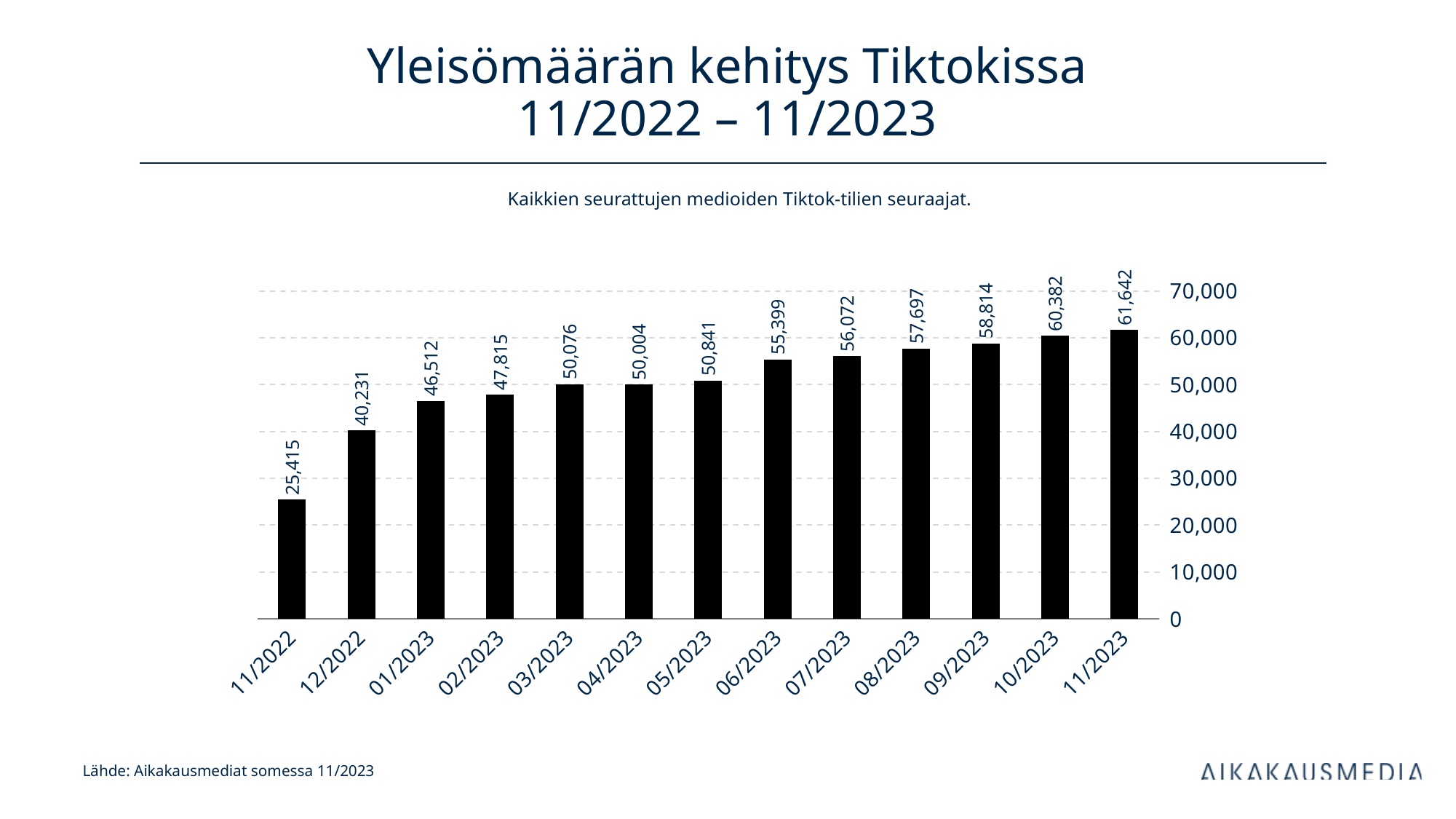
Do the values generally rise or fall from 11/2022 to 11/2023? rise What is the value for 06/2023? 55,399 Which month has the highest value? 11/2023 Is the value for 02/2023 greater or less than 50,000? less What is the value for 11/2023? 61,642 What is the difference between the values for 11/2023 and 11/2022? 36,227 Which month has the lowest value? 11/2022 What is the difference between the values for 12/2022 and 11/2022? 14,816 What kind of chart is shown on the slide? bar chart Which is larger, the value for 03/2023 or the value for 04/2023? 03/2023 What is the value for 11/2022? 25,415 How many months are shown on the x axis? 13